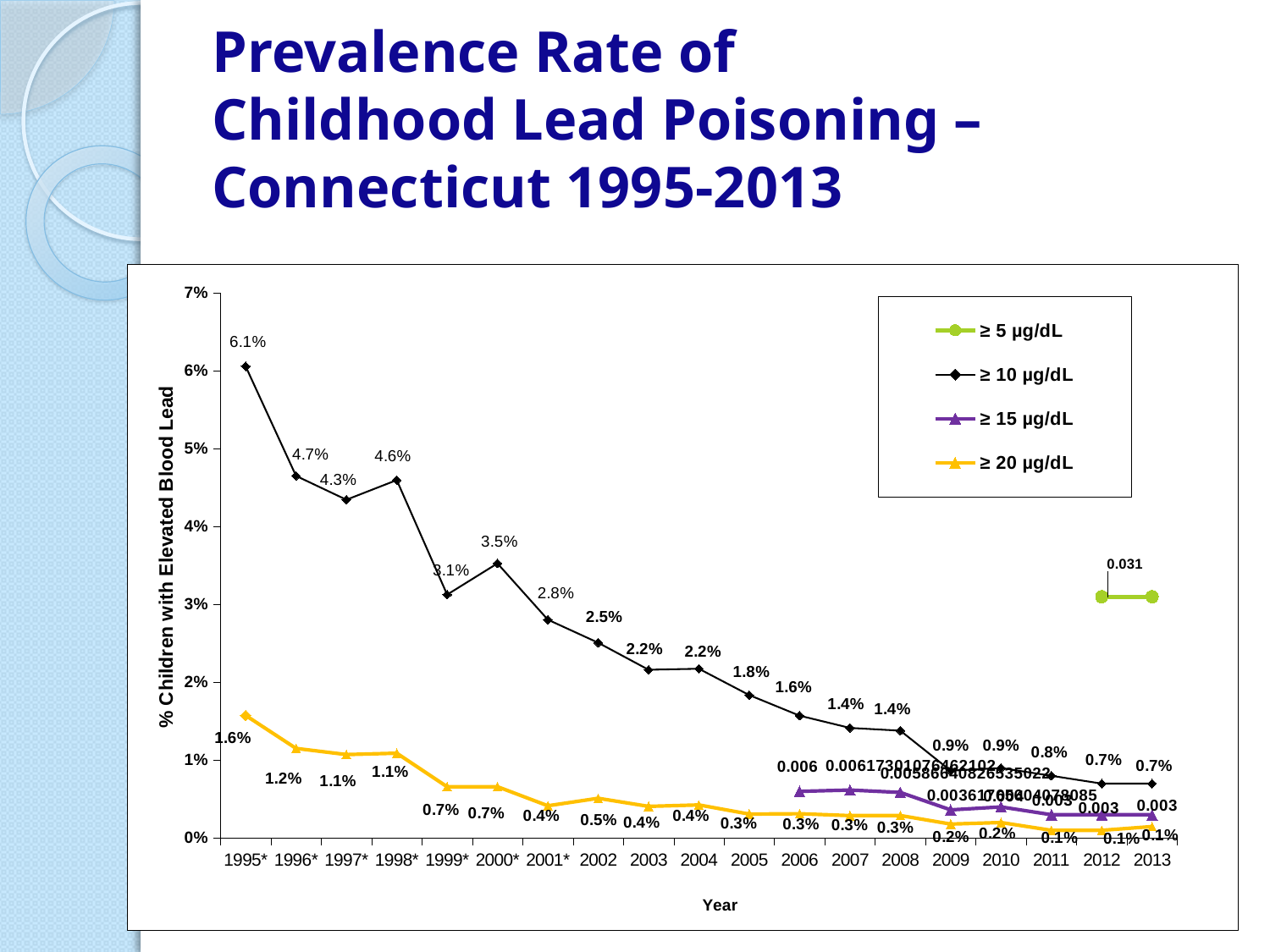
What is the value of the ≥ 20 µg/dL series in 2013? 0.1% What is the difference between the ≥ 10 µg/dL value in 1995* and in 2013? 5.4 percentage points What is the value of the ≥ 20 µg/dL series in 1995*? 1.6% How many series does the legend list? 4 In which year is the ≥ 10 µg/dL series highest? 1995* What kind of chart is shown on the slide? Line chart What is the labelled value of the ≥ 5 µg/dL series in 2012? 0.031 What is the value of the ≥ 10 µg/dL series in 2005? 1.8% How many years are shown on the x axis? 19 Which year has the larger ≥ 10 µg/dL value, 1997* or 1998*? 1998* Does the ≥ 10 µg/dL series rise or fall from 1995* to 2013? Fall What is the value of the ≥ 10 µg/dL series in 1995*? 6.1%